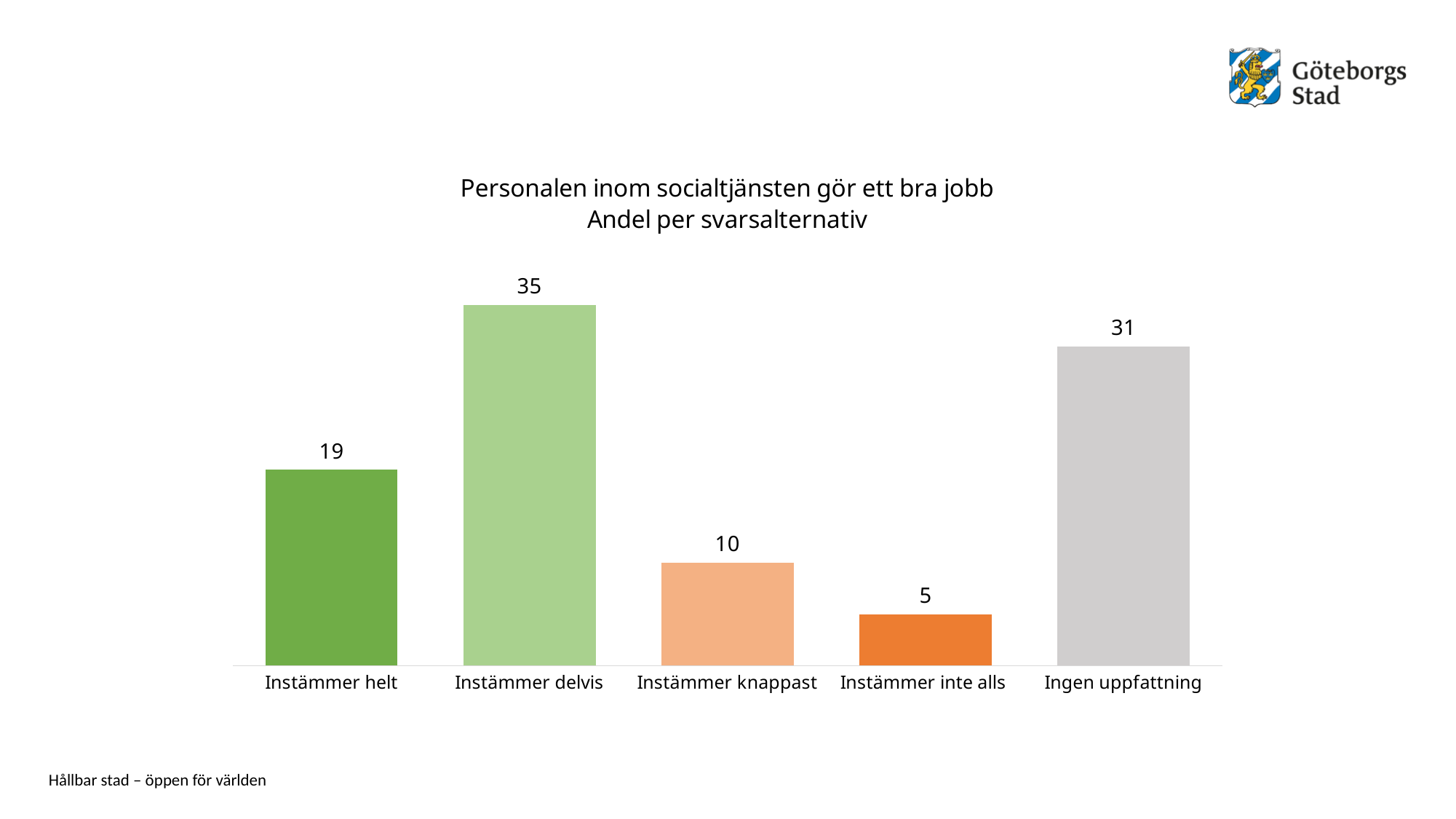
What is the value for Ingen uppfattning? 31 What is the value for Instämmer helt? 19 What is the value for Instämmer delvis? 35 What is the title of the chart? Personalen inom socialtjänsten gör ett bra jobb Andel per svarsalternativ What is the value for Instämmer inte alls? 5 What is the value for Instämmer knappast? 10 How many categories are shown in the chart? 5 What is the difference between the values for Instämmer delvis and Ingen uppfattning? 4 Which category has the highest value? Instämmer delvis Which is larger, the value for Instämmer helt or the value for Instämmer knappast? Instämmer helt What kind of chart is shown on the slide? Bar chart Which category has the lowest value? Instämmer inte alls